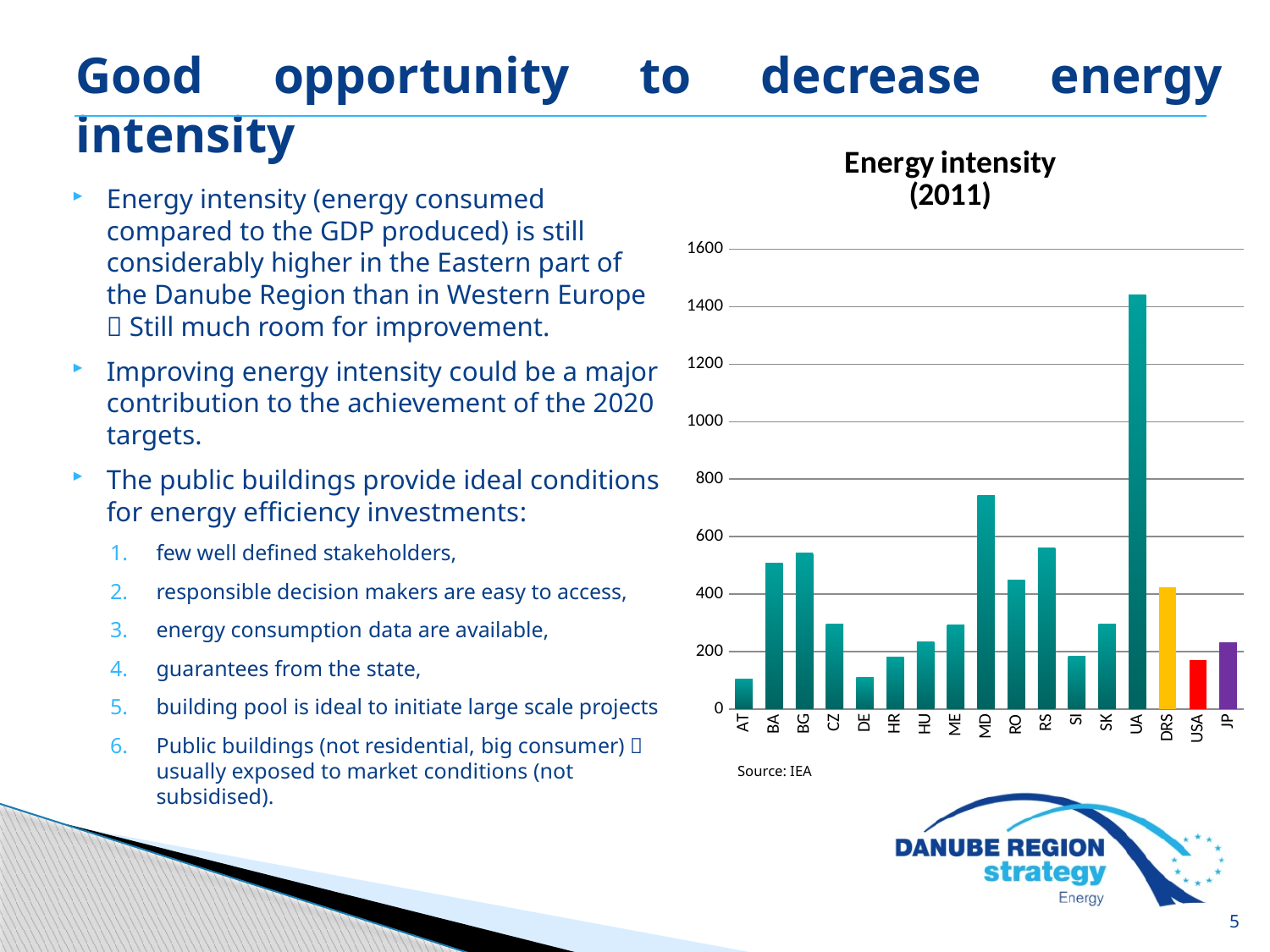
What source is cited below the chart? IEA Is the value for BA greater or less than 400? greater What type of chart is shown on the slide? bar chart Is the value for MD greater or less than 800? less Is the value for MD greater or less than 600? greater Which category has the highest energy intensity in the chart? UA How many categories are shown on the x axis of the chart? 17 What is the title of the chart? Energy intensity (2011) Which has the larger energy intensity, MD or RO? MD